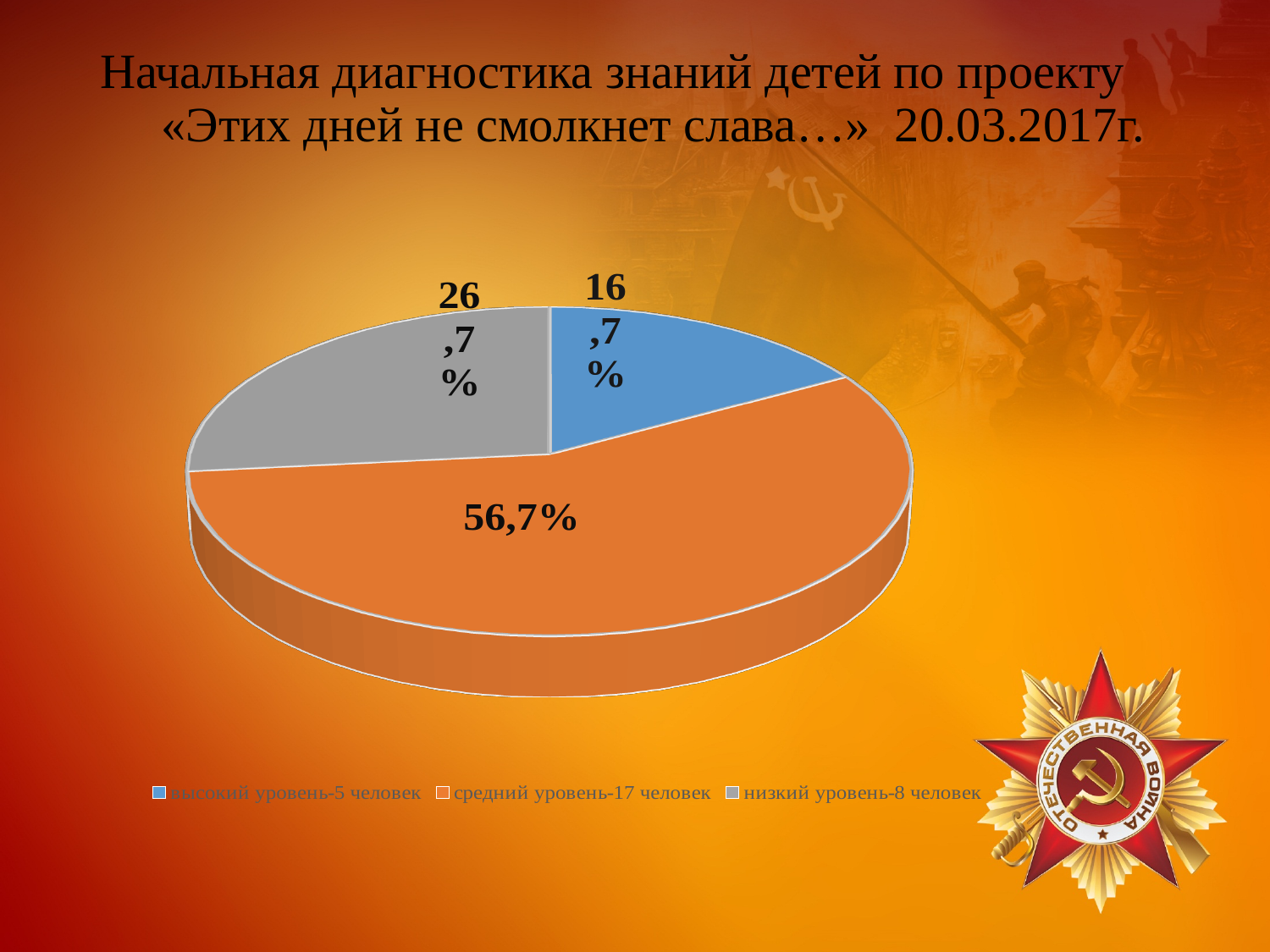
Which slice of the pie chart is the smallest? высокий уровень-5 человек What percentage is shown for the slice "высокий уровень-5 человек"? 16,7% What percentage is shown for the slice "средний уровень-17 человек"? 56,7% Which slice of the pie chart is the largest? средний уровень-17 человек How many entries does the legend list? 3 What date is given in the chart title? 20.03.2017г. What percentage is shown for the slice "низкий уровень-8 человек"? 26,7% What kind of chart is shown on the slide? pie chart What colour is the slice for "средний уровень-17 человек"? orange How many slices does the pie chart have? 3 What is the difference in percentage points between the "средний уровень-17 человек" slice and the "низкий уровень-8 человек" slice? 30 percentage points Which is larger: the slice for "низкий уровень-8 человек" or the slice for "высокий уровень-5 человек"? низкий уровень-8 человек